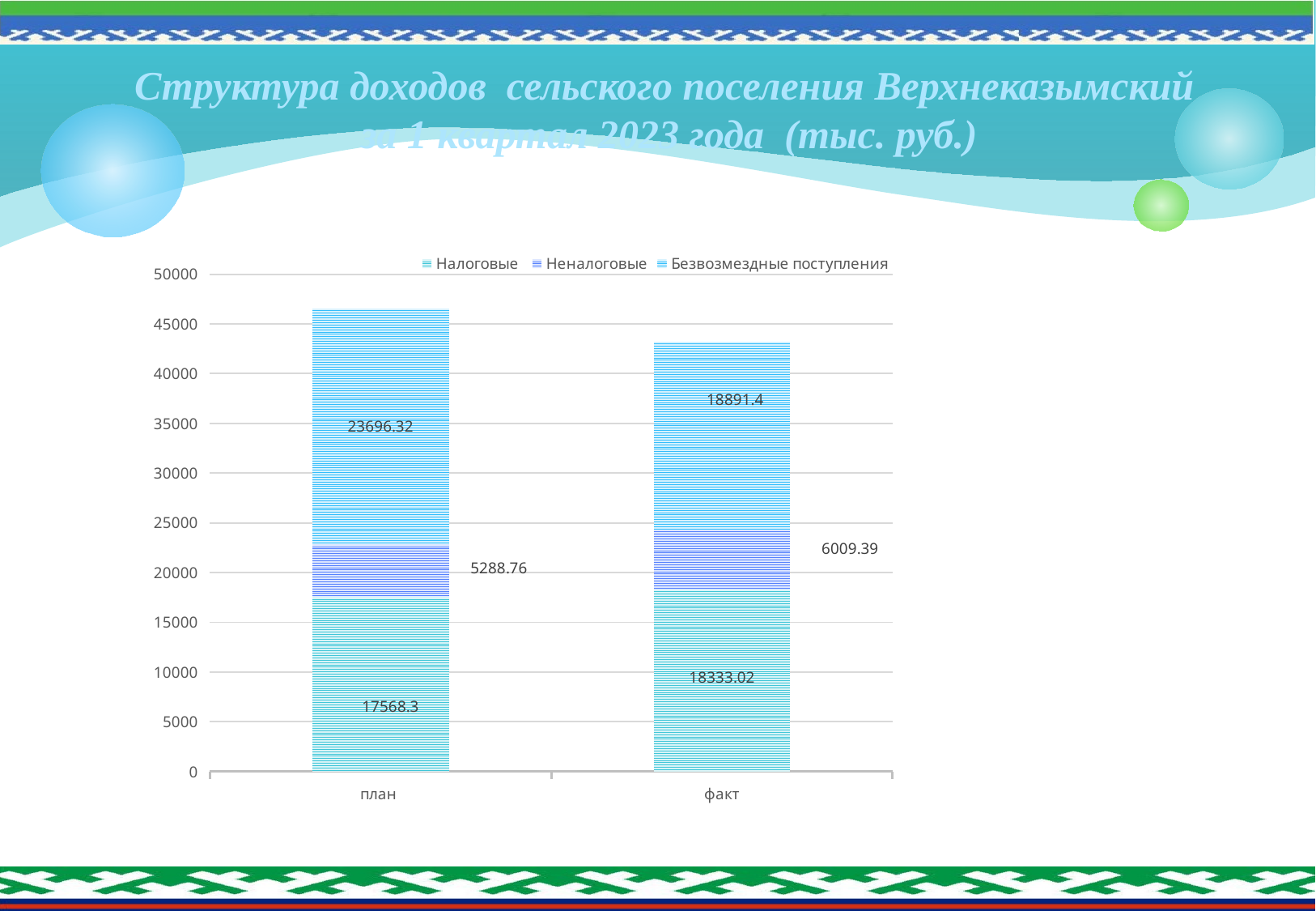
How many series does the legend list? 3 What is the value of Безвозмездные поступления for план? 23696.32 Which is larger, Налоговые for план or Налоговые for факт? факт Which series is listed first in the legend? Налоговые What is the value of Безвозмездные поступления for факт? 18891.4 What is the total of the stacked bar for план? 46553.38 What is the difference between Безвозмездные поступления for план and for факт? 4804.92 How many categories are shown on the x axis? 2 What is the total of the stacked bar for факт? 43233.81 What is the value of Неналоговые for факт? 6009.39 What is the value of Налоговые for план? 17568.3 What type of chart is shown on the slide? stacked bar chart